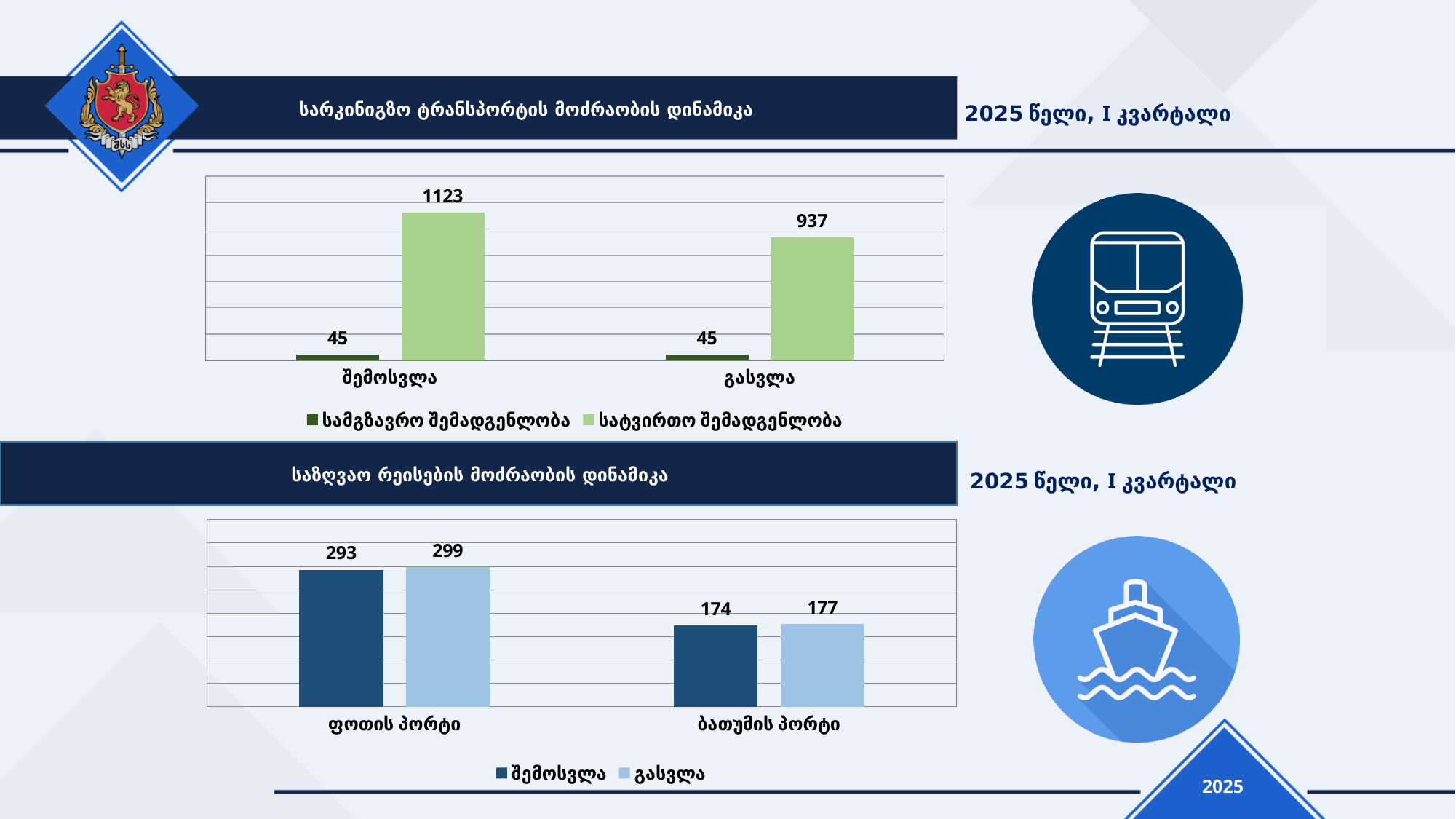
In the bottom chart (საზღვაო რეისების მოძრაობის დინამიკა), what is the difference between the გასვლა values for ფოთის პორტი and ბათუმის პორტი? 122 What type of chart is the bottom chart (საზღვაო რეისების მოძრაობის დინამიკა)? Bar chart In the bottom chart (საზღვაო რეისების მოძრაობის დინამიკა), what is the გასვლა value for ბათუმის პორტი? 177 In the bottom chart (საზღვაო რეისების მოძრაობის დინამიკა), how many categories are shown on the x axis? 2 In the top chart (სარკინიგზო ტრანსპორტის მოძრაობის დინამიკა), what is the difference between the სატვირთო შემადგენლობა values for შემოსვლა and გასვლა? 186 In the top chart (სარკინიგზო ტრანსპორტის მოძრაობის დინამიკა), which series has the higher value for გასვლა? სატვირთო შემადგენლობა In the top chart (სარკინიგზო ტრანსპორტის მოძრაობის დინამიკა), how many series does the legend list? 2 In the bottom chart (საზღვაო რეისების მოძრაობის დინამიკა), which port has the higher შემოსვლა value? ფოთის პორტი In the top chart (სარკინიგზო ტრანსპორტის მოძრაობის დინამიკა), what is the value of სატვირთო შემადგენლობა for გასვლა? 937 In the top chart (სარკინიგზო ტრანსპორტის მოძრაობის დინამიკა), what is the value of სატვირთო შემადგენლობა for შემოსვლა? 1123 In the top chart (სარკინიგზო ტრანსპორტის მოძრაობის დინამიკა), what is the value of სამგზავრო შემადგენლობა for შემოსვლა? 45 In the bottom chart (საზღვაო რეისების მოძრაობის დინამიკა), what is the შემოსვლა value for ფოთის პორტი? 293